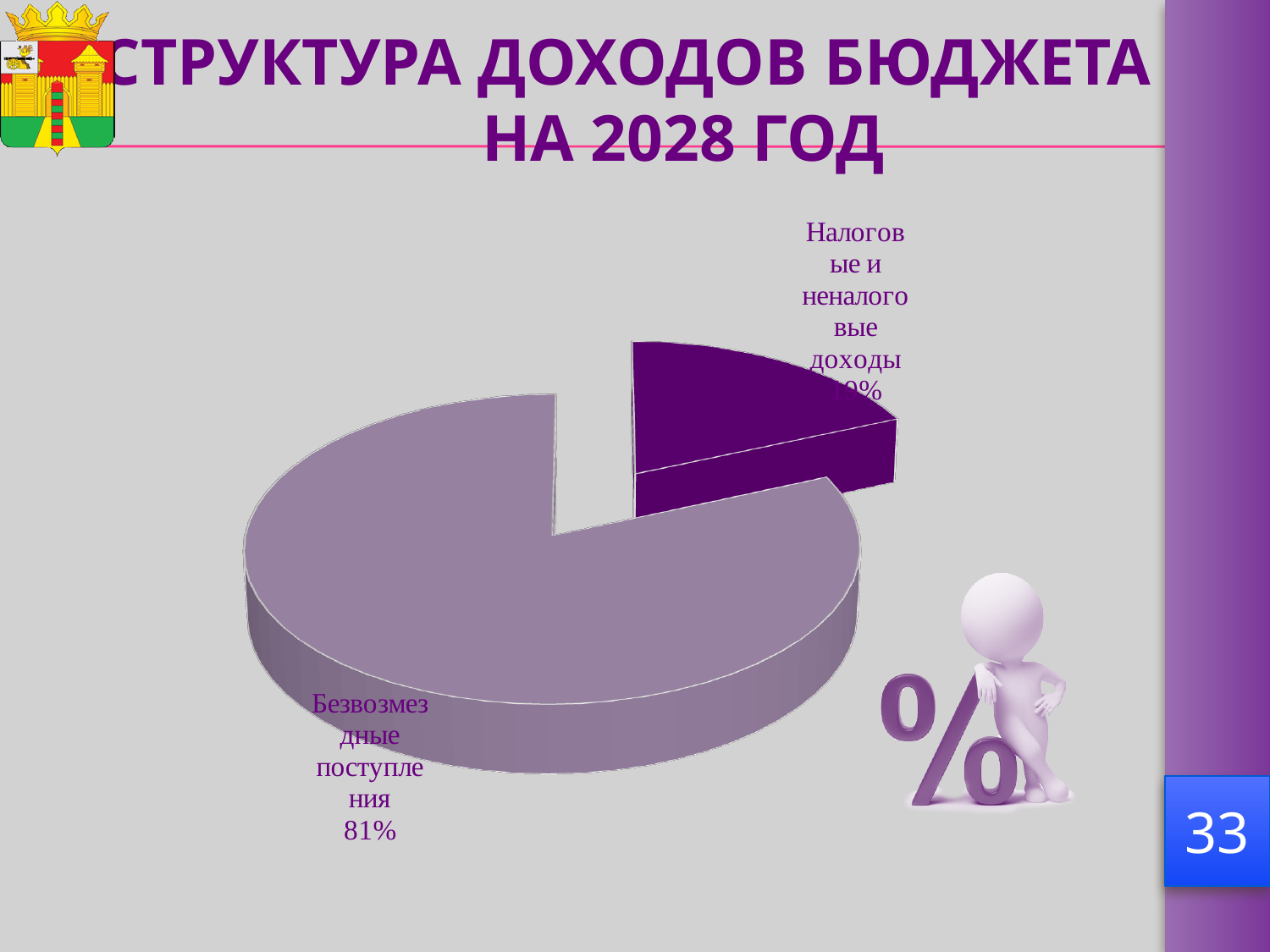
What kind of chart is shown on the slide? pie chart What share of the pie does "Безвозмездные поступления" account for? 81% Which category has the largest slice of the pie? Безвозмездные поступления Which slice of the pie is drawn in dark purple? Налоговые и неналоговые доходы Is the share for "Налоговые и неналоговые доходы" greater or less than 50%? less What is the title of the slide containing the pie chart? СТРУКТУРА ДОХОДОВ БЮДЖЕТА НА 2028 ГОД Is the share for "Безвозмездные поступления" greater or less than 50%? greater Which is larger: the slice for "Безвозмездные поступления" or the slice for "Налоговые и неналоговые доходы"? Безвозмездные поступления Which category has the smallest slice of the pie? Налоговые и неналоговые доходы How many slices does the pie chart have? 2